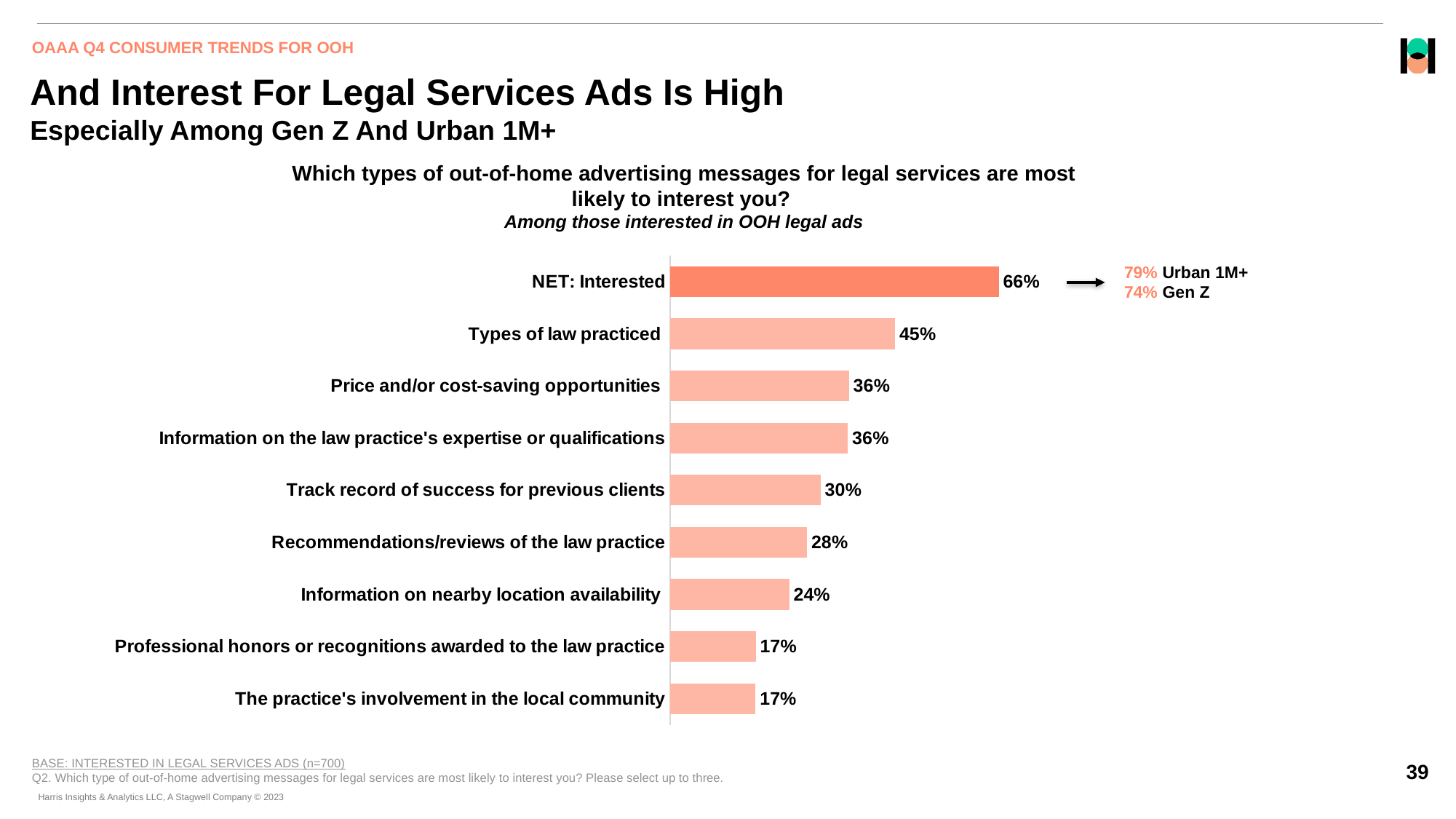
What is the difference between NET: Interested and Types of law practiced? 21% Excluding the NET: Interested bar, which category has the highest value? Types of law practiced What percentage of Urban 1M+ respondents is shown next to the NET: Interested bar? 79% What percentage of Gen Z respondents is shown next to the NET: Interested bar? 74% What kind of chart is shown on the slide? Bar chart Which is larger: Price and/or cost-saving opportunities or Information on nearby location availability? Price and/or cost-saving opportunities What is the value for NET: Interested? 66% What is the value for Types of law practiced? 45% What is the value for Track record of success for previous clients? 30% What is the difference between Types of law practiced and Recommendations/reviews of the law practice? 17% What is the value for Information on nearby location availability? 24% How many bars are shown in the chart? 9